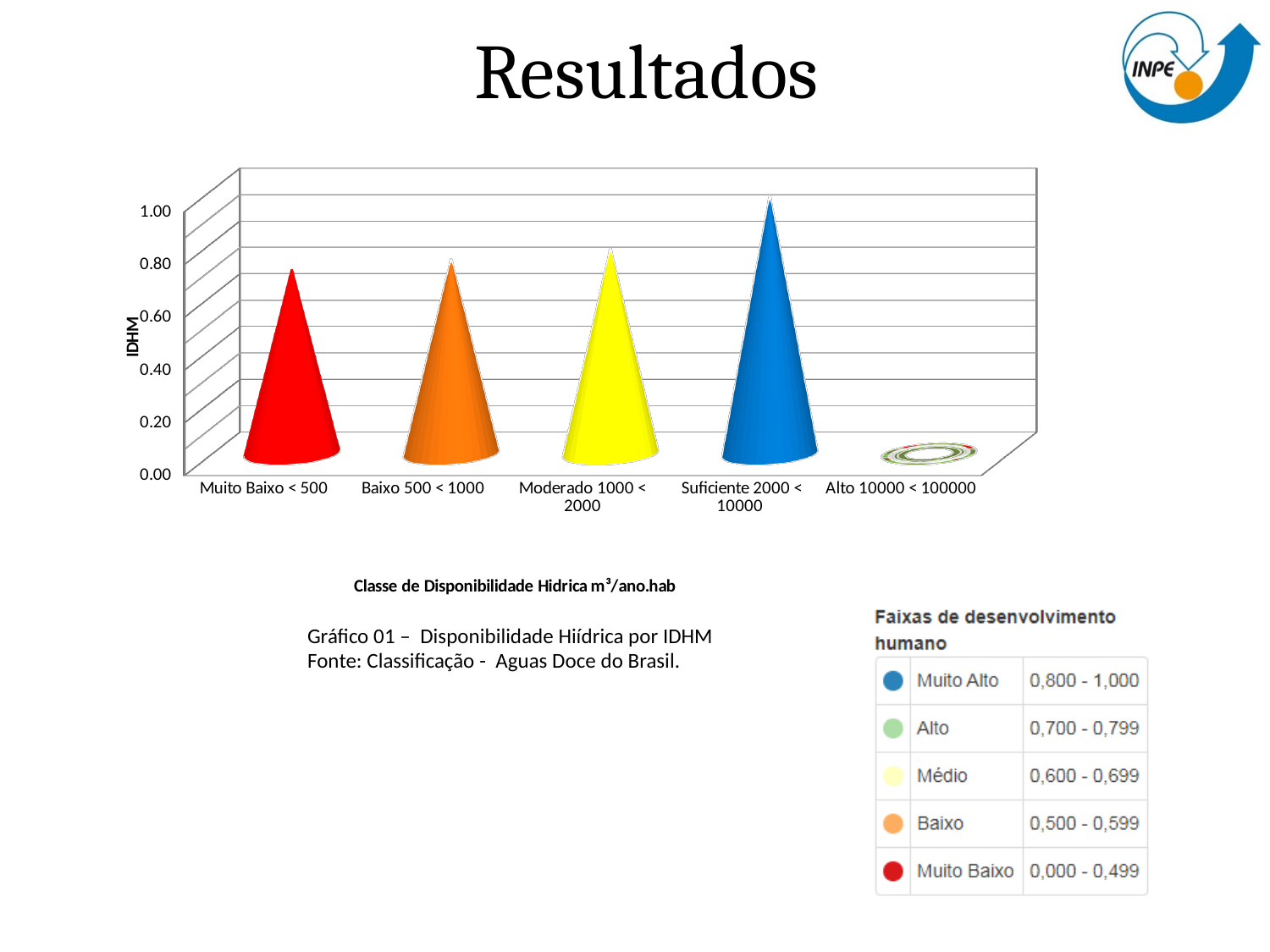
What is the title of the horizontal axis of the chart? Classe de Disponibilidade Hidrica m³/ano.hab Which category has the lowest IDHM value in the chart? Alto 10000 < 100000 What is the label of the vertical axis of the chart? IDHM Which category has the highest IDHM value in the chart? Suficiente 2000 < 10000 Is the value for Muito Baixo < 500 greater or less than 0.60? greater Is the value for Baixo 500 < 1000 greater or less than 0.40? greater How many categories are shown on the x axis of the chart? 5 Is the value for Moderado 1000 < 2000 greater or less than 0.60? greater What kind of chart is shown on the slide? bar chart Which has the larger value: Suficiente 2000 < 10000 or Moderado 1000 < 2000? Suficiente 2000 < 10000